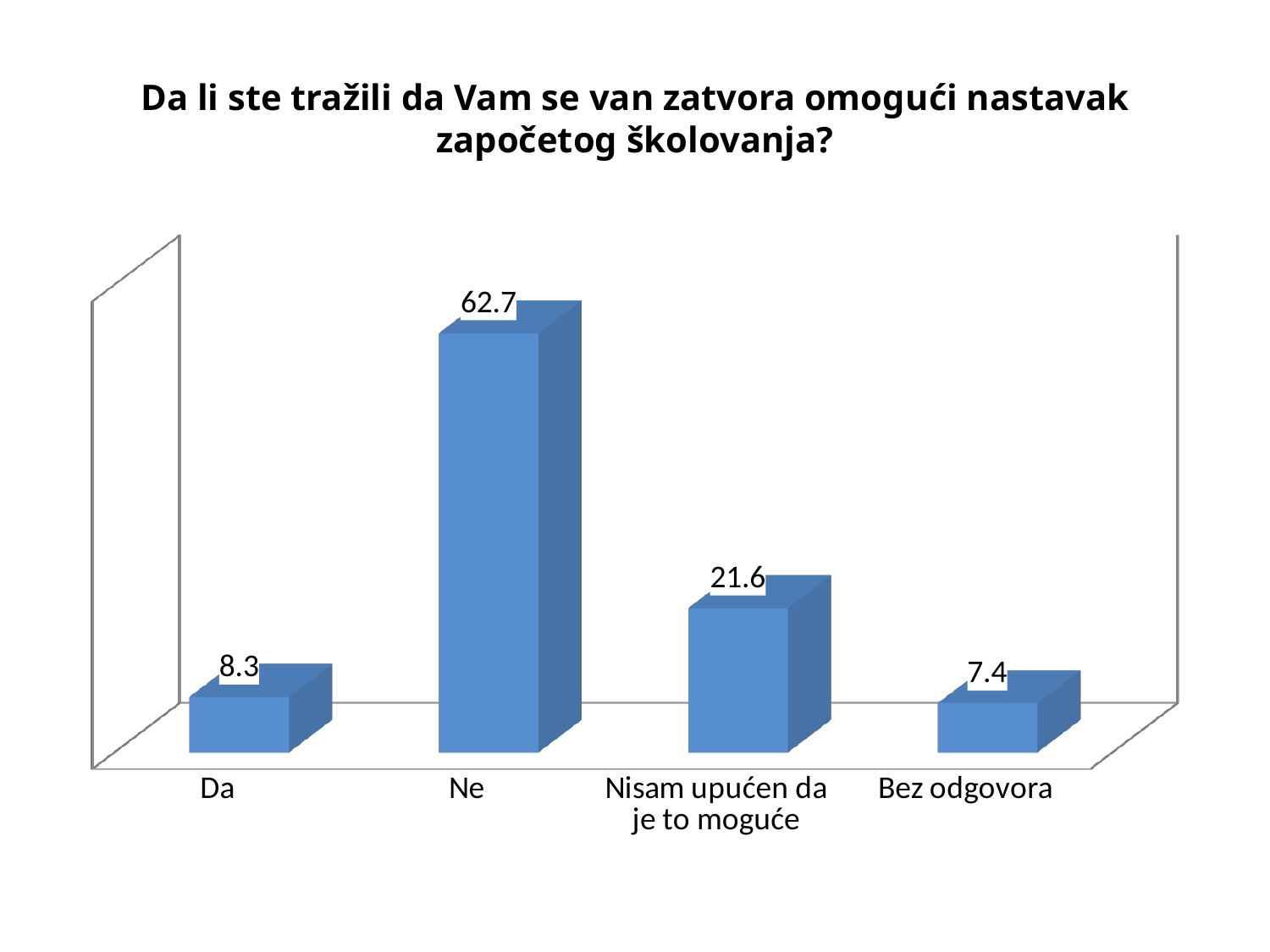
What is the value for "Bez odgovora"? 7.4 What kind of chart is shown on the slide? Bar chart What is the value for "Da"? 8.3 Which category has the highest value? Ne What is the value for "Ne"? 62.7 What is the difference between the values for "Ne" and "Nisam upućen da je to moguće"? 41.1 What is the value for "Nisam upućen da je to moguće"? 21.6 Which category has the lowest value? Bez odgovora Which is larger, the value for "Da" or the value for "Nisam upućen da je to moguće"? Nisam upućen da je to moguće How many categories are shown on the x axis? 4 What is the difference between the values for "Da" and "Bez odgovora"? 0.9 What is the title of the chart? Da li ste tražili da Vam se van zatvora omogući nastavak započetog školovanja?